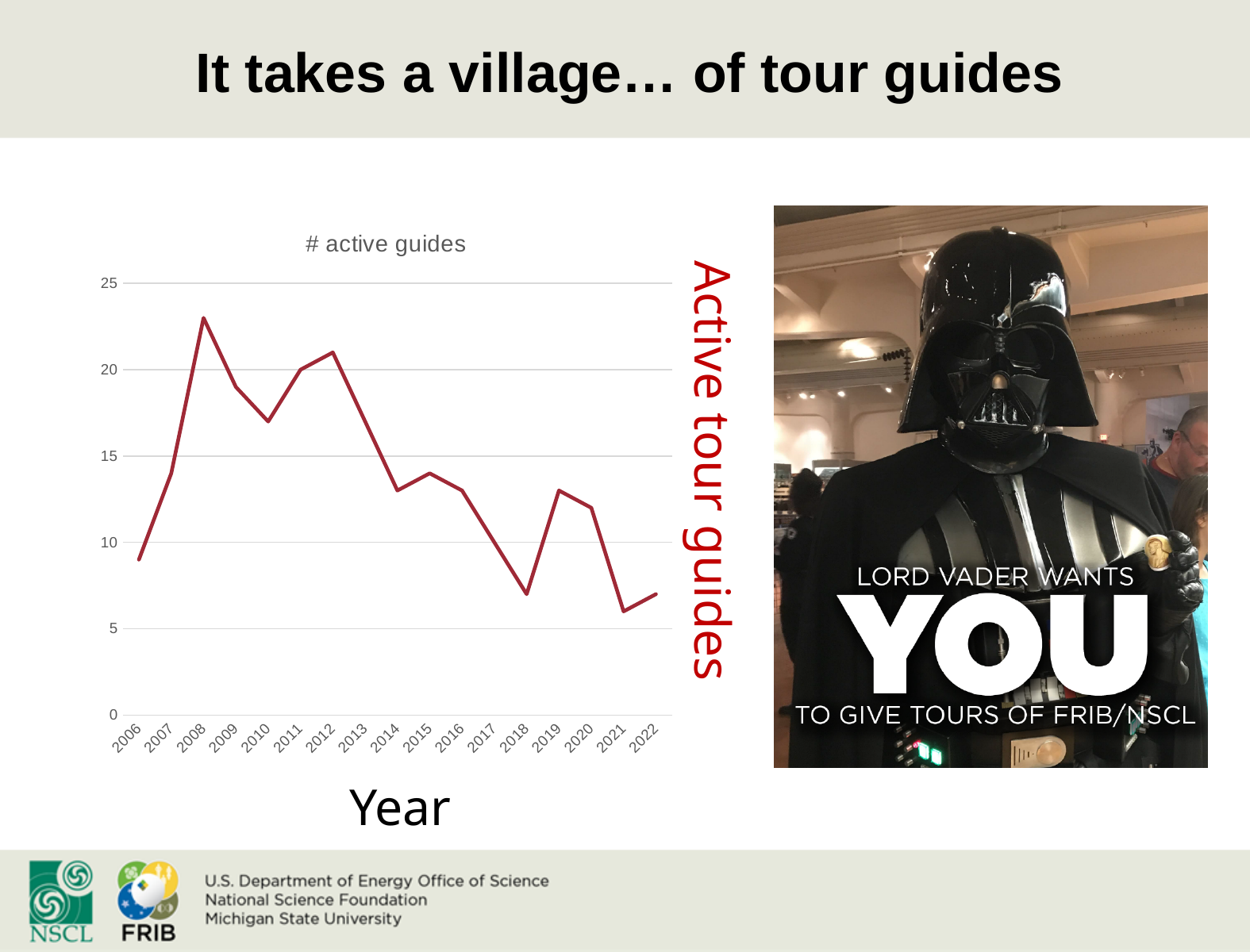
Overall, does the number of active guides rise or fall from 2008 to 2022? fall How many years are plotted on the x axis of the chart? 17 In which year was the number of active guides highest? 2008 Which year had more active guides, 2008 or 2022? 2008 What is the label on the x axis of the chart? Year Is the number of active guides in 2008 greater or less than 20? greater Is the number of active guides in 2021 greater or less than 10? less What is the title of the chart? # active guides What kind of chart is shown on the slide? line chart In which year was the number of active guides lowest? 2021 Is the number of active guides in 2018 greater or less than 10? less